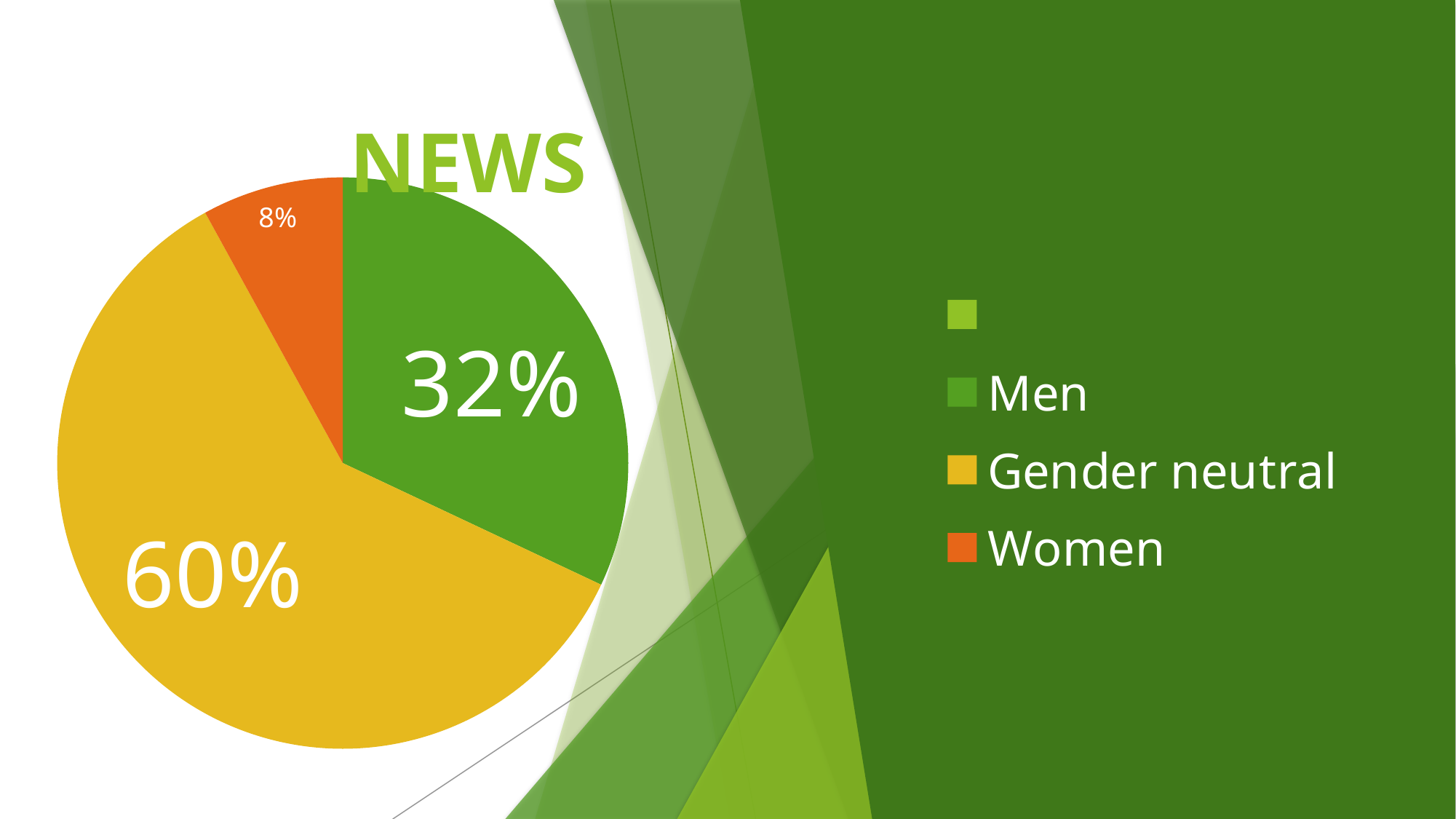
What is the difference in percentage points between the Men slice and the Women slice? 24 How many slices does the pie chart have? 3 What type of chart is shown on the slide? Pie chart What percentage of the pie is labelled for Men? 32% Which category has the smallest slice of the pie? Women What percentage of the pie is labelled for Gender neutral? 60% Which slice is larger, Men or Women? Men What colour is the Women slice in the pie chart? Orange What percentage of the pie is labelled for Women? 8% What is the title of the chart? NEWS What is the difference in percentage points between the Gender neutral slice and the Men slice? 28 Which category has the largest slice of the pie? Gender neutral